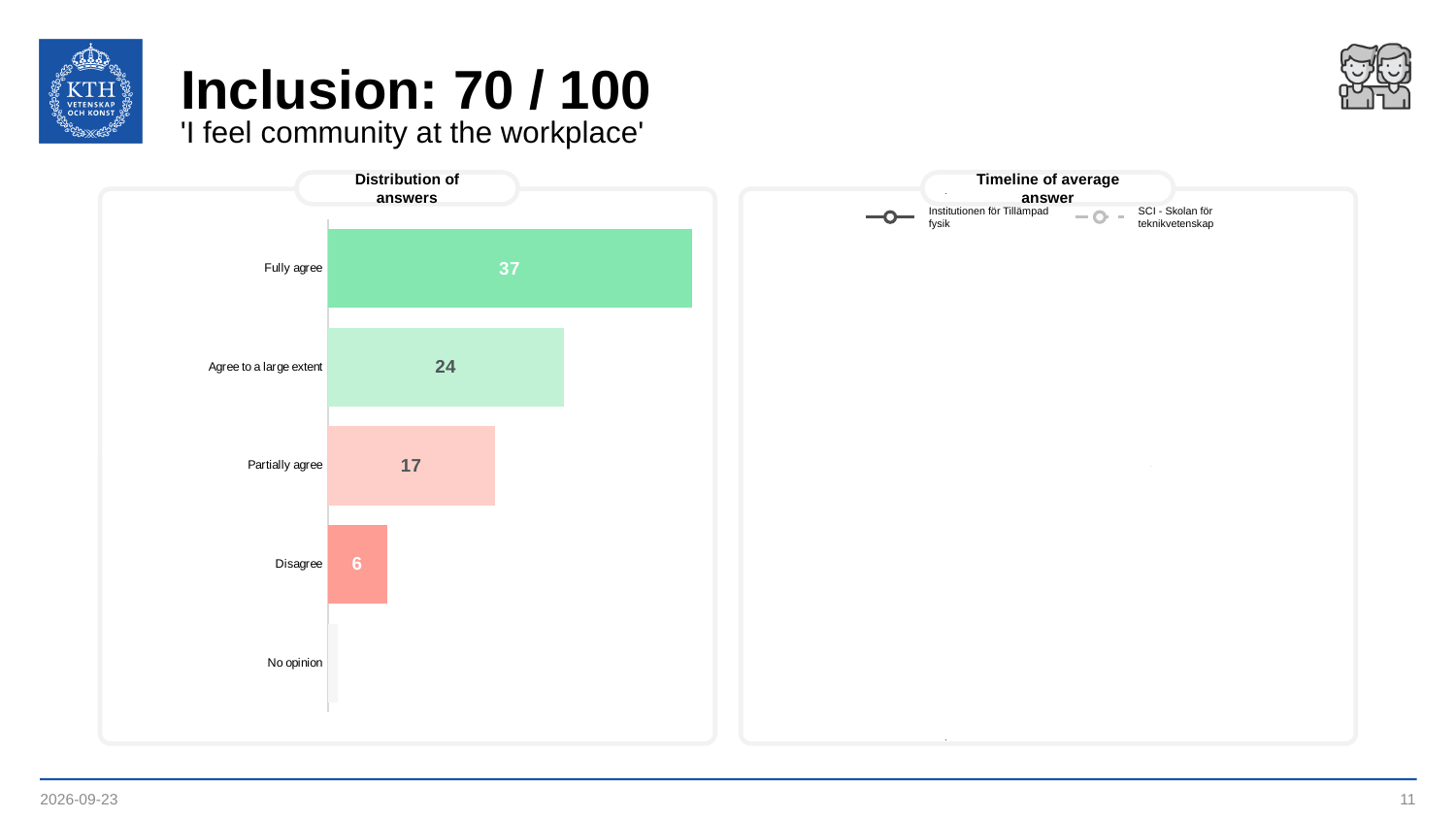
In the 'Distribution of answers' chart, what is the difference between 'Fully agree' and 'Agree to a large extent'? 13 In the 'Distribution of answers' chart, what is the value for 'Partially agree'? 17 How many series does the legend of the 'Timeline of average answer' chart list? 2 In the 'Distribution of answers' chart, what is the value for 'Agree to a large extent'? 24 In the 'Distribution of answers' chart, what is the value for 'Disagree'? 6 In the 'Distribution of answers' chart, what is the difference between 'Partially agree' and 'Disagree'? 11 In the 'Distribution of answers' chart, what is the value for 'Fully agree'? 37 How many categories are shown in the 'Distribution of answers' chart? 5 What kind of chart is the 'Distribution of answers' chart? Bar chart In the 'Distribution of answers' chart, which is larger: 'Agree to a large extent' or 'Partially agree'? Agree to a large extent In the 'Distribution of answers' chart, which category has the highest value? Fully agree In the 'Distribution of answers' chart, which category has the lowest value? No opinion